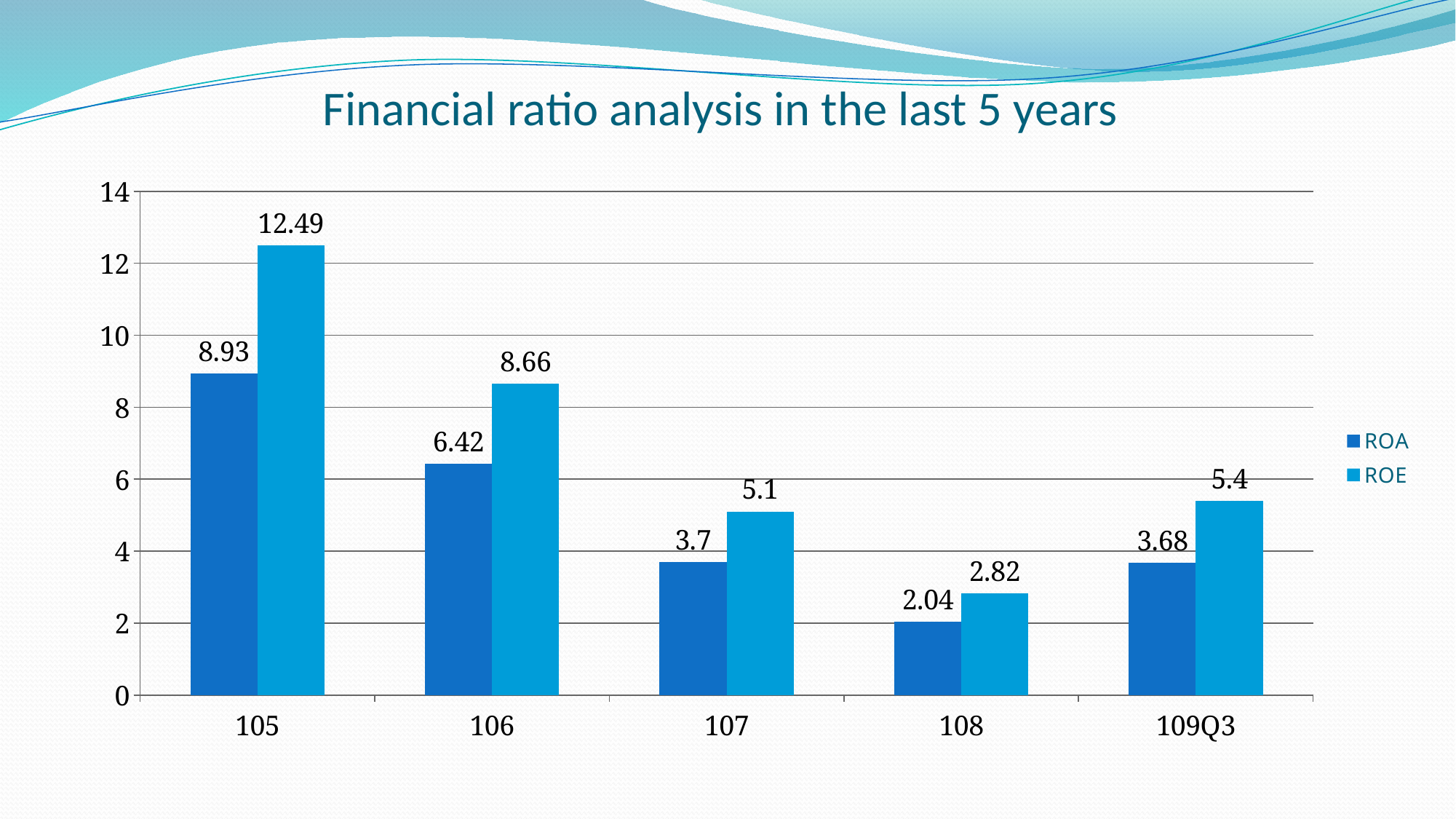
How many series does the legend list? 2 What is the difference between the ROE and ROA values for 106? 2.24 What is the title of the chart? Financial ratio analysis in the last 5 years What is the ROE value for 109Q3? 5.4 What kind of chart is shown on the slide? bar chart How many categories are shown on the x axis? 5 Is the ROE value for 105 greater or less than 12? greater Which category has the lowest ROA value? 108 Which category has the highest ROE value? 105 Which is larger, the ROA value for 107 or the ROA value for 109Q3? ROA for 107 What is the ROE value for 108? 2.82 What is the ROA value for 105? 8.93